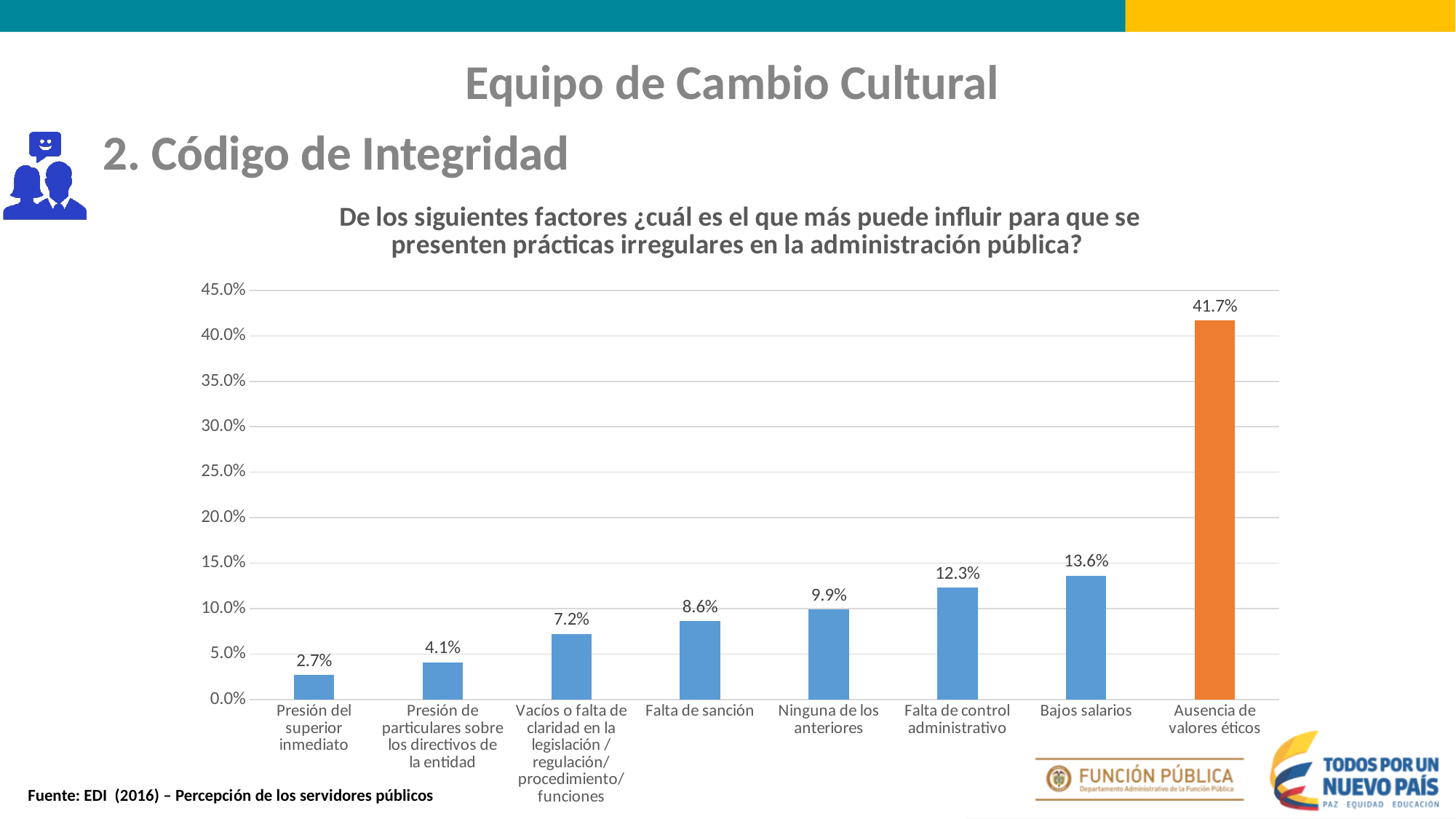
What is the value for Ausencia de valores éticos? 41.7% What is the value for Bajos salarios? 13.6% What kind of chart is shown on the slide? Bar chart Which is larger, Vacíos o falta de claridad en la legislación / regulación/ procedimiento/ funciones or Presión de particulares sobre los directivos de la entidad? Vacíos o falta de claridad en la legislación / regulación/ procedimiento/ funciones What is the difference between Falta de control administrativo and Ninguna de los anteriores? 2.4% What is the difference between Ausencia de valores éticos and Bajos salarios? 28.1% How many categories are shown on the chart? 8 Which category has the highest value? Ausencia de valores éticos Which bar is coloured orange instead of blue? Ausencia de valores éticos What is the value for Falta de sanción? 8.6% Is the value for Falta de control administrativo greater or less than 10.0%? greater Which category has the lowest value? Presión del superior inmediato